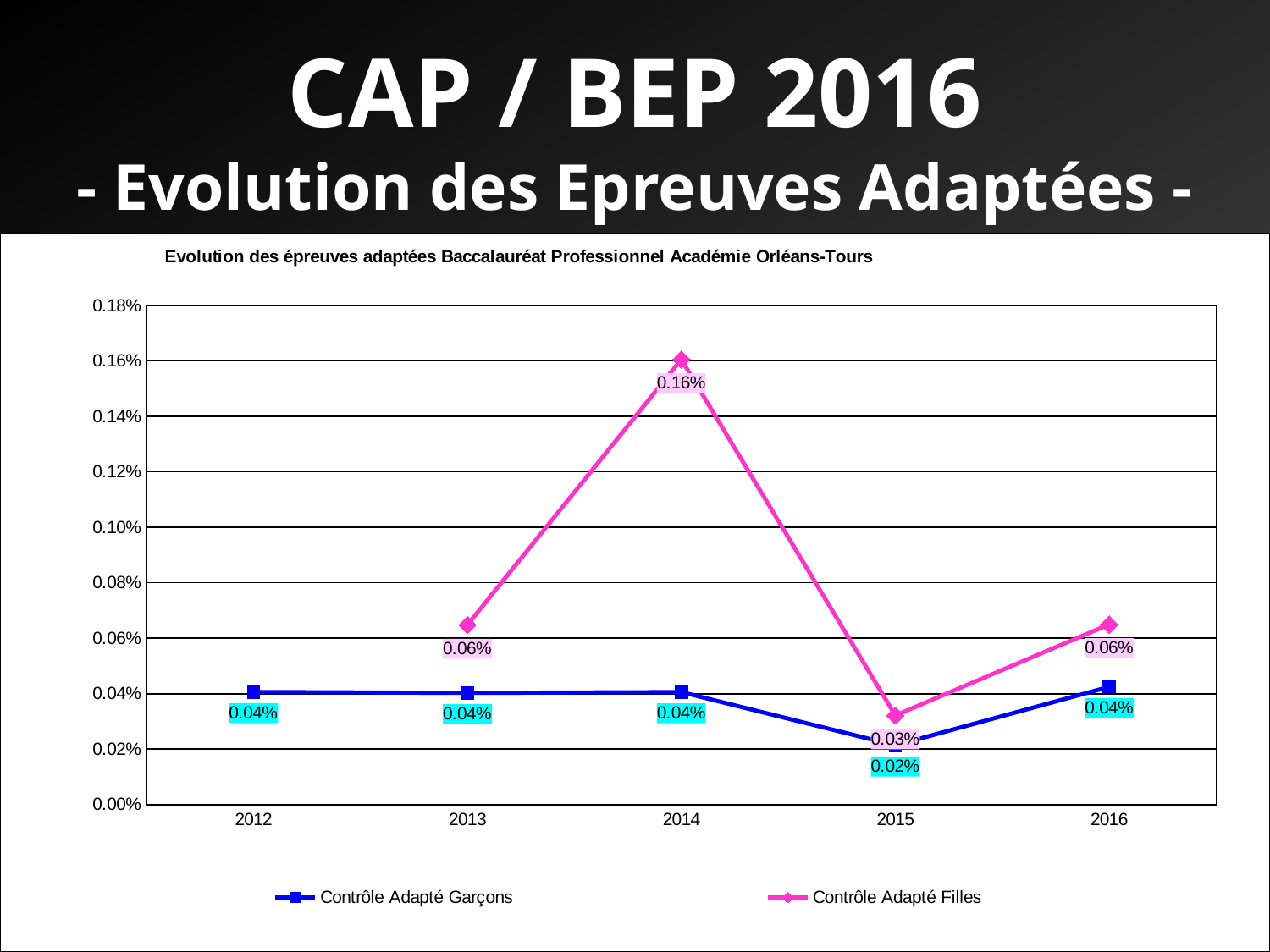
What kind of chart is shown on the slide? Line chart Is the value for Contrôle Adapté Filles in 2014 greater or less than 0.10%? greater How many years are shown on the x axis? 5 What is the value for Contrôle Adapté Garçons in 2015? 0.02% What is the value for Contrôle Adapté Filles in 2013? 0.06% What is the title of the chart? Evolution des épreuves adaptées Baccalauréat Professionnel Académie Orléans-Tours What is the value for Contrôle Adapté Filles in 2014? 0.16% In which year does Contrôle Adapté Garçons have its lowest value? 2015 Which series has the larger value in 2015, Contrôle Adapté Garçons or Contrôle Adapté Filles? Contrôle Adapté Filles What is the difference between Contrôle Adapté Filles and Contrôle Adapté Garçons in 2014? 0.12% In which year does Contrôle Adapté Filles reach its highest value? 2014 How many series does the legend list? 2